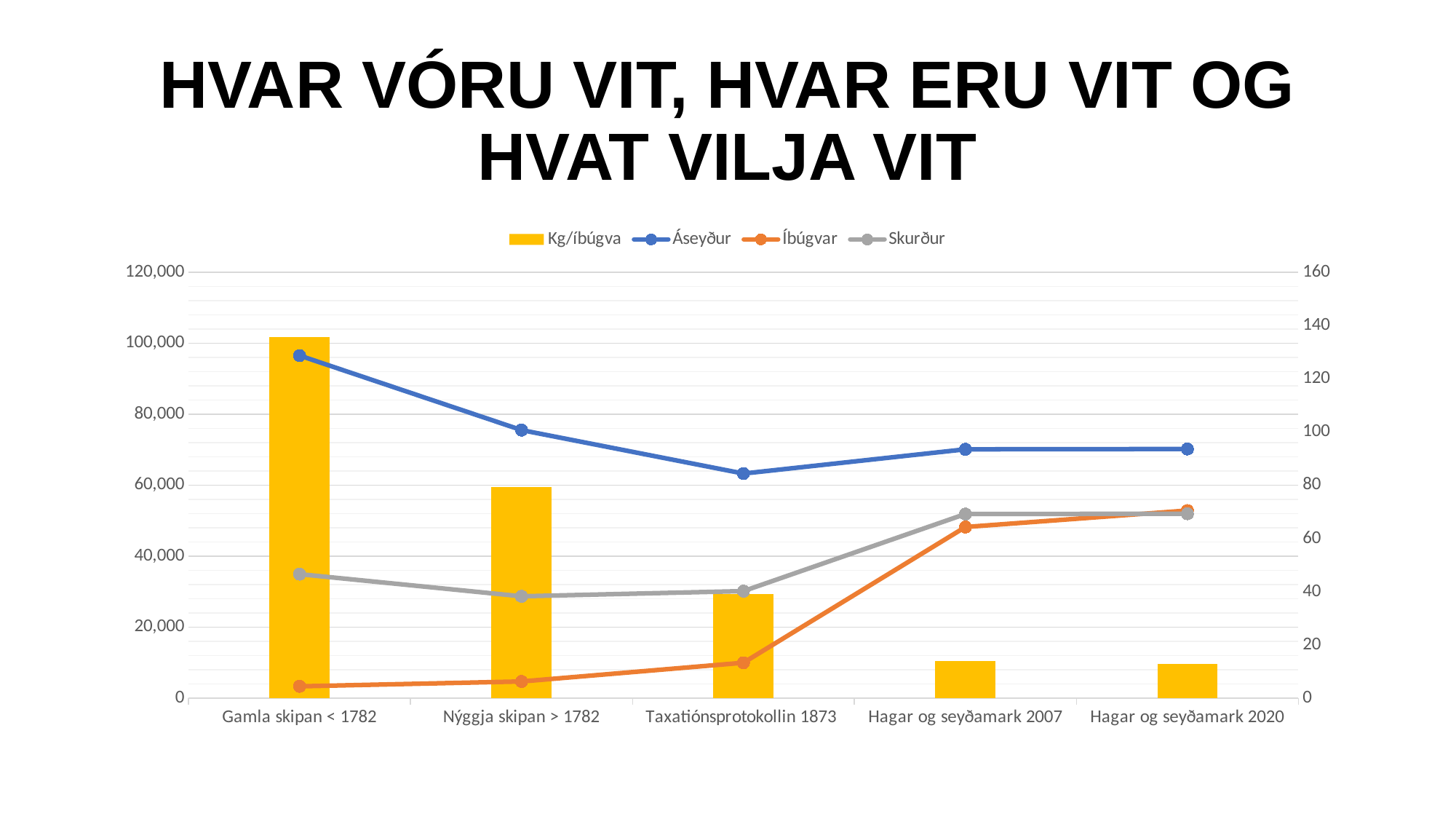
How many series does the chart legend list? 4 Which category has the highest Áseyður value? Gamla skipan < 1782 Which is larger for Hagar og seyðamark 2020: the Áseyður value or the Skurður value? Áseyður Which category has the lowest Áseyður value? Taxatiónsprotokollin 1873 Is the Áseyður value for Gamla skipan < 1782 greater or less than 120? greater Does the Íbúgvar line rise or fall from Gamla skipan < 1782 to Hagar og seyðamark 2020? rises Which category has the highest Kg/íbúgva bar? Gamla skipan < 1782 How many categories are shown on the x axis of the chart? 5 What kind of chart is shown on the slide? Combined bar and line chart